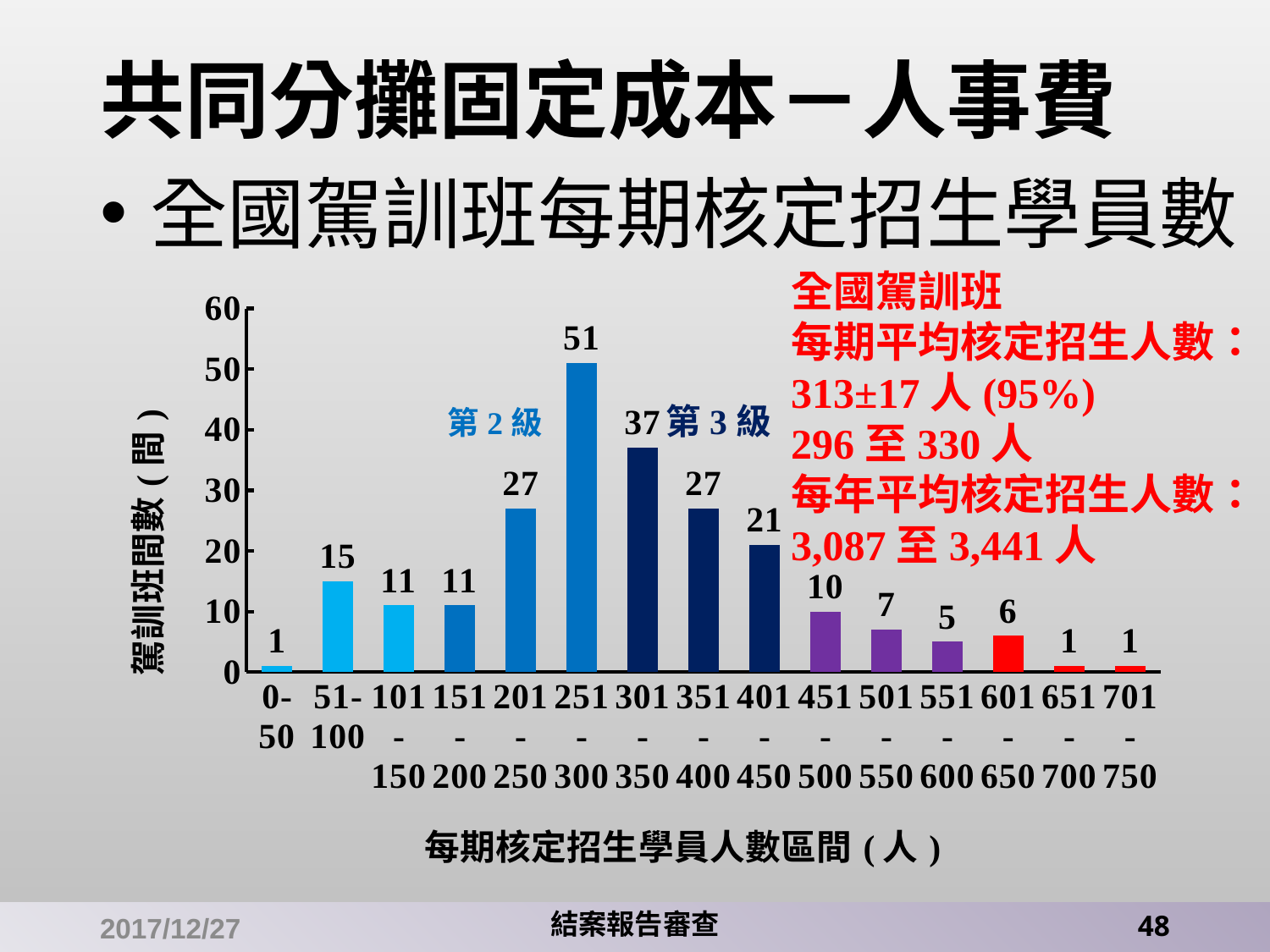
What is the label of the x axis? 每期核定招生學員人數區間（人） What is the label of the y axis? 駕訓班間數（間） How many driving schools (駕訓班間數) fall in the 251-300 range? 51 How many categories (ranges) are shown on the x axis? 15 What type of chart is shown on the slide? bar chart Which is larger, the value for 451-500 or the value for 501-550? 451-500 What is the value for the 51-100 category? 15 What is the value for the 601-650 category? 6 What is the value for the 401-450 category? 21 Which category has the highest number of driving schools? 251-300 What is the difference between the values for 251-300 and 301-350? 14 What is the difference between the values for 201-250 and 551-600? 22